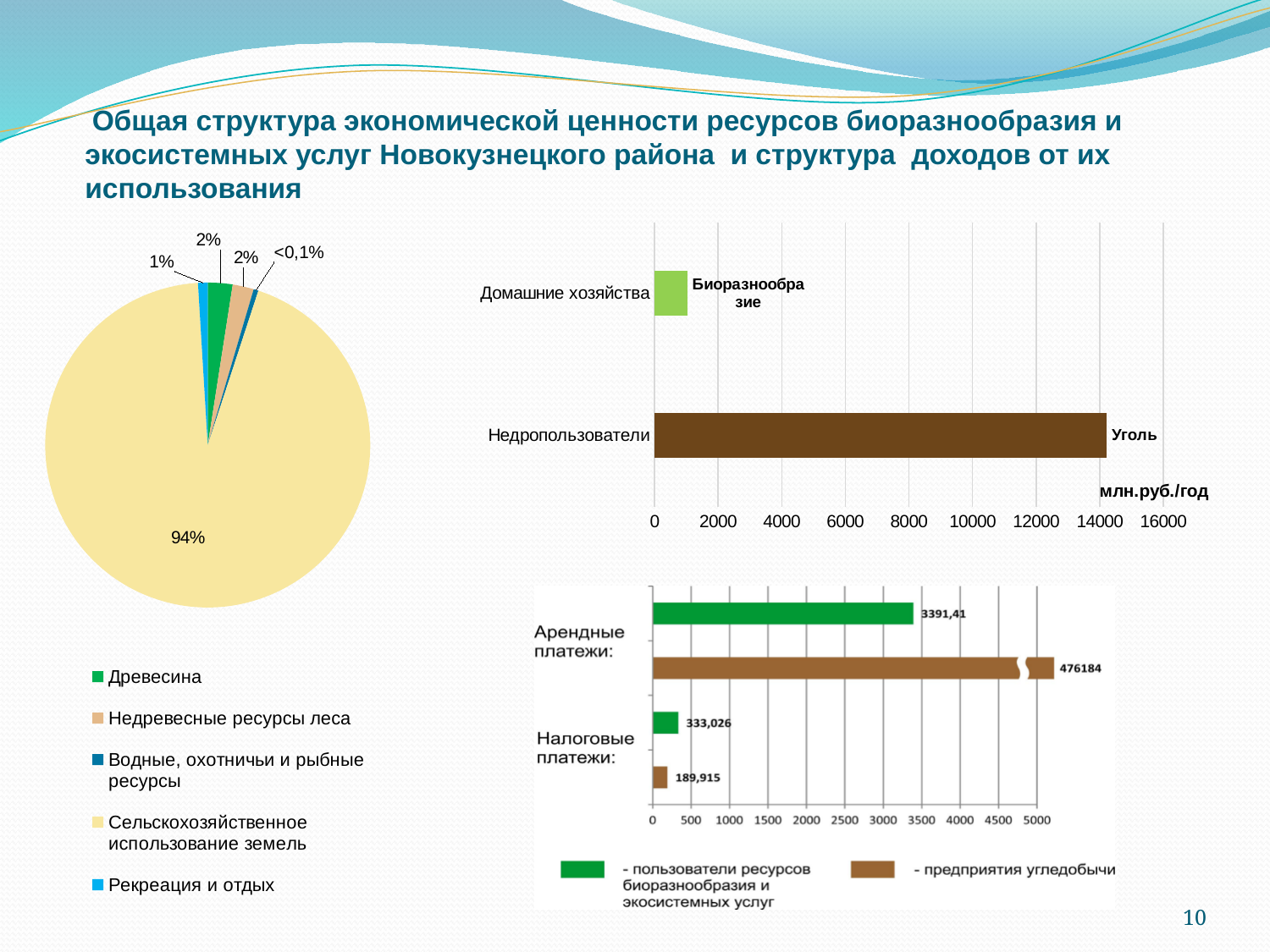
What type of chart is the top-right chart with the categories Домашние хозяйства and Недропользователи? bar chart In the top-right bar chart, is the value for Домашние хозяйства greater or less than 2000? less In the bottom-right bar chart, what is the value of Арендные платежи for предприятия угледобычи (brown bar)? 476184 How many categories does the legend of the pie chart on the left list? 5 In the pie chart on the left, which category has the largest share? Сельскохозяйственное использование земель In the pie chart on the left, what share does Сельскохозяйственное использование земель have? 94% In the top-right bar chart, is the value for Недропользователи greater or less than 12000? greater In the pie chart on the left, what share is shown for Водные, охотничьи и рыбные ресурсы? <0,1% In the bottom-right bar chart, what is the value of Налоговые платежи for предприятия угледобычи (brown bar)? 189,915 In the top-right bar chart (млн.руб./год), which category has the higher value: Домашние хозяйства or Недропользователи? Недропользователи In the pie chart on the left, what share does Рекреация и отдых have? 1% In the bottom-right bar chart, what is the value of Арендные платежи for пользователи ресурсов биоразнообразия и экосистемных услуг (green bar)? 3391,41